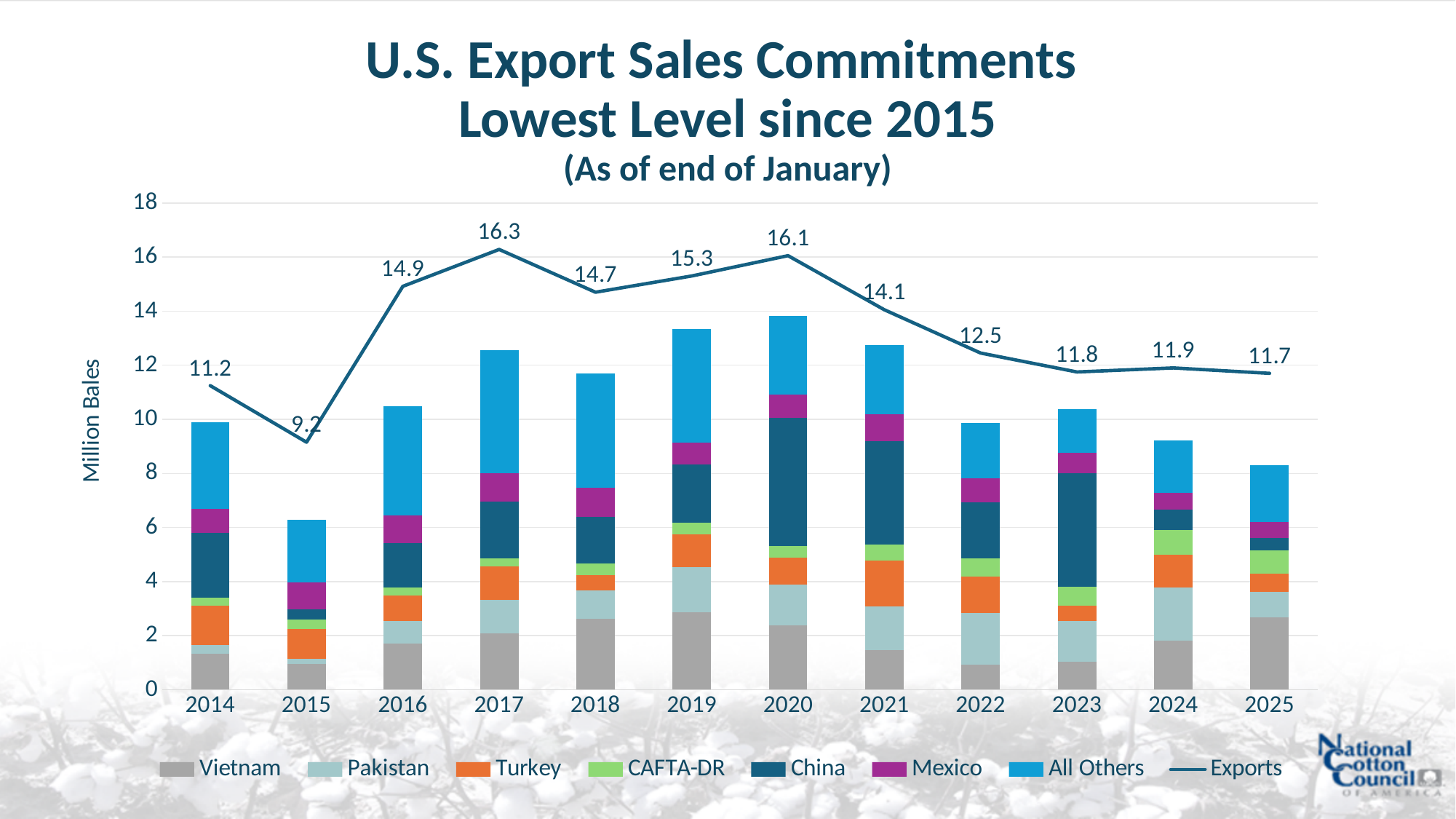
What is the Exports value for 2025? 11.7 How many years are shown on the x axis? 12 Is the total height of the stacked bar for 2020 greater or less than 12? greater What is the difference between the Exports values for 2017 and 2015? 7.1 Which year has the larger Exports value, 2024 or 2025? 2024 How many entries does the legend list? 8 What is the Exports value for 2015? 9.2 In which year is the Exports line at its lowest? 2015 Does the Exports line rise or fall from 2020 to 2023? fall What is the Exports value for 2017? 16.3 Is the total height of the stacked bar for 2015 greater or less than 8? less In which year is the Exports line at its highest? 2017